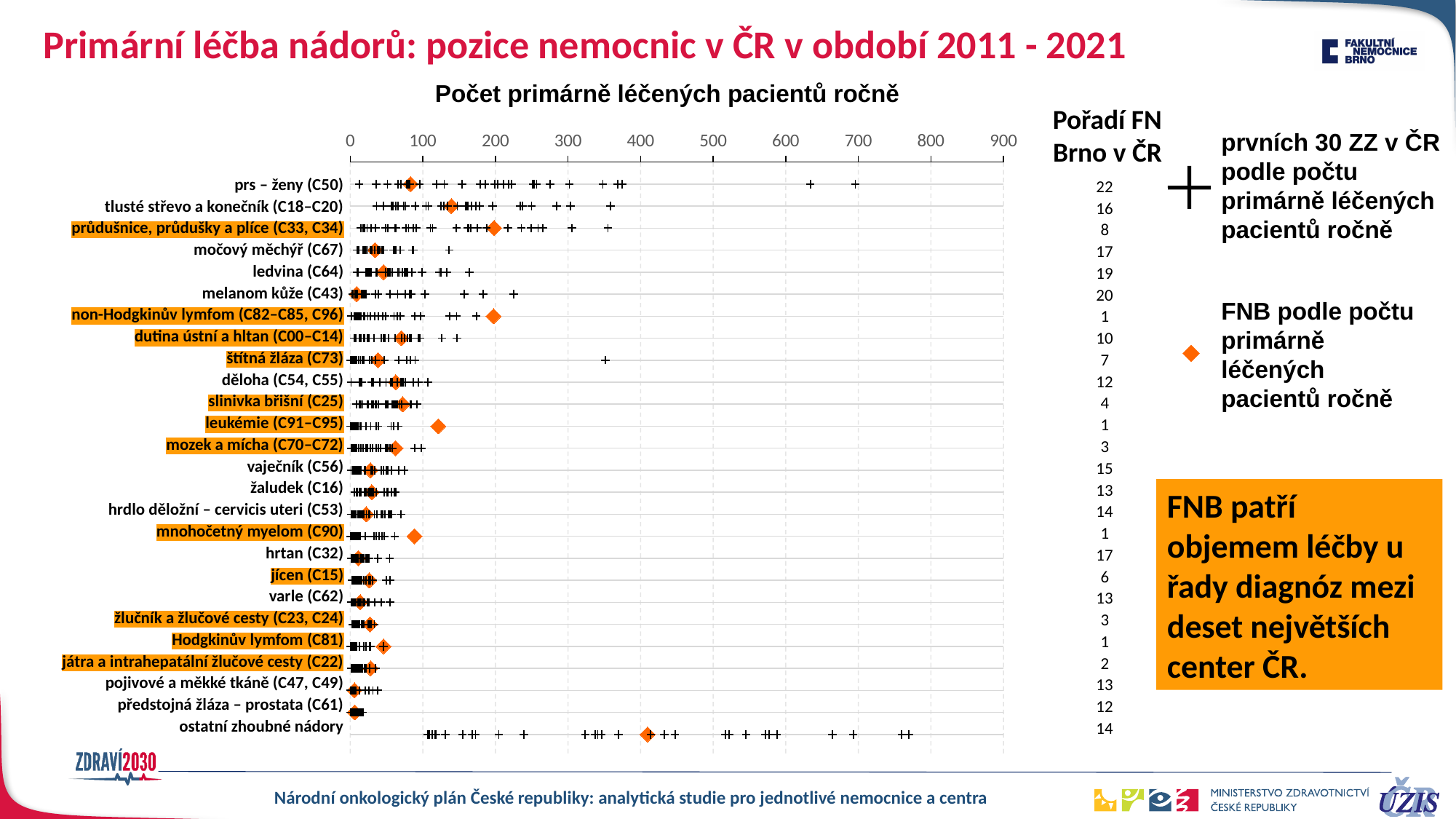
Is the FNB value (orange diamond) for 'ostatní zhoubné nádory' greater or less than 300? greater What is the highest value shown on the chart's x axis? 900 What kind of chart is shown on the slide? scatter (dot) plot Is the FNB value (orange diamond) for 'leukémie (C91–C95)' greater or less than 100? greater How many series does the chart legend list? 2 According to the 'Pořadí FN Brno v ČR' column, what is FN Brno's rank for 'Hodgkinův lymfom (C81)'? 1 Is the FNB value (orange diamond) for 'prs – ženy (C50)' greater or less than 100? less Which is larger, the FNB value for 'leukémie (C91–C95)' or for 'mnohočetný myelom (C90)'? leukémie (C91–C95) According to the 'Pořadí FN Brno v ČR' column, what is FN Brno's rank for 'průdušnice, průdušky a plíce (C33, C34)'? 8 According to the 'Pořadí FN Brno v ČR' column, what is FN Brno's rank for 'prs – ženy (C50)'? 22 What is the title of the chart? Počet primárně léčených pacientů ročně How many diagnosis categories are plotted on the y axis of the chart? 26